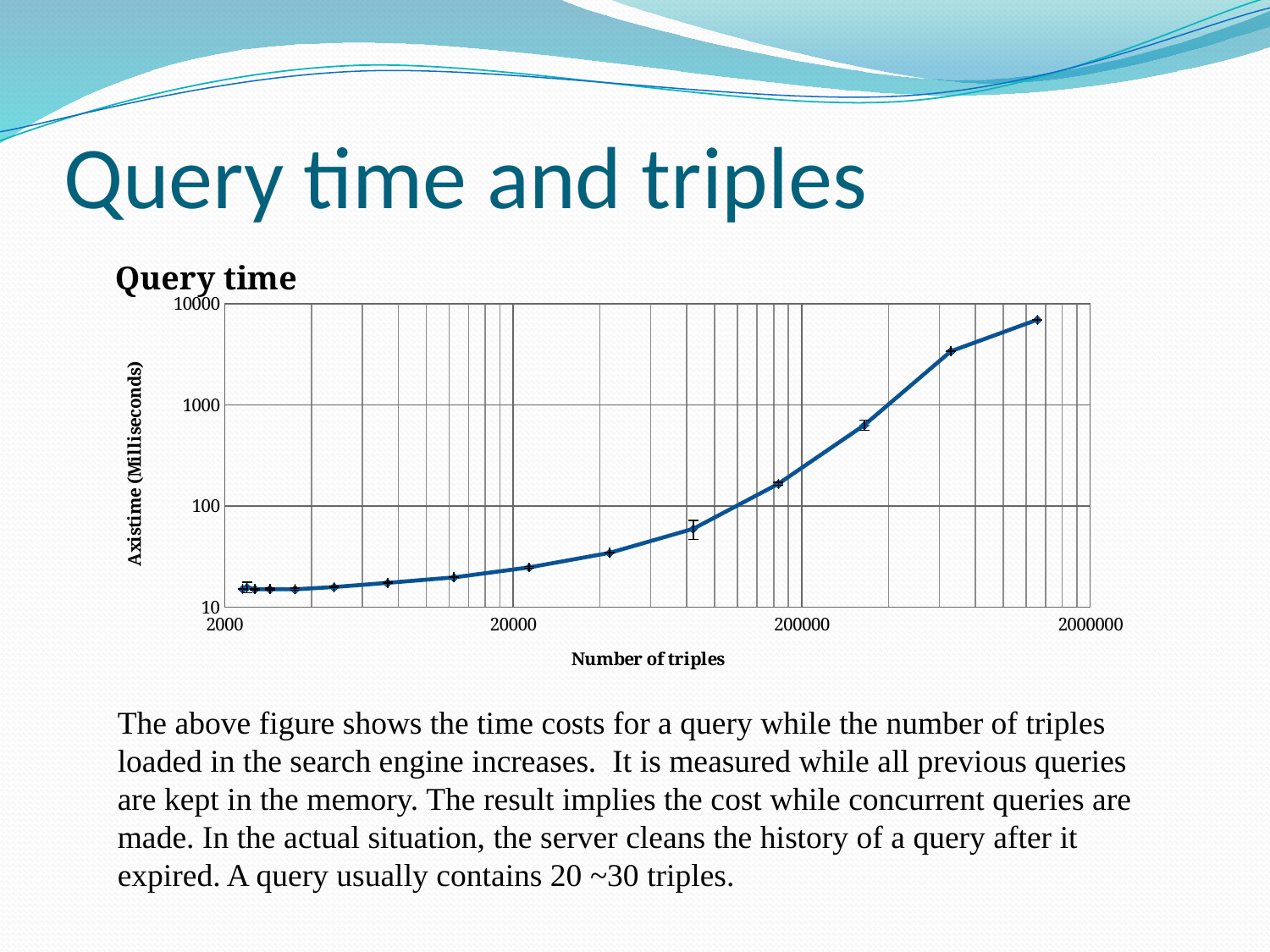
Does the query time rise or fall as the number of triples increases along the x axis? rise What is the title of the chart? Query time Which data point has the lowest query time: the one near 2000 triples or the one near 200000 triples? the one near 2000 triples What kind of chart is shown on the slide? line chart Is the query time at the leftmost data point (around 2000 triples) greater or less than 100 milliseconds? less Is the query time at the rightmost data point greater or less than 10000 milliseconds? less What is the label of the x axis of the chart? Number of triples Is the query time at the rightmost data point (the largest number of triples) greater or less than 1000 milliseconds? greater Which has the higher query time: the leftmost data point or the rightmost data point? the rightmost data point